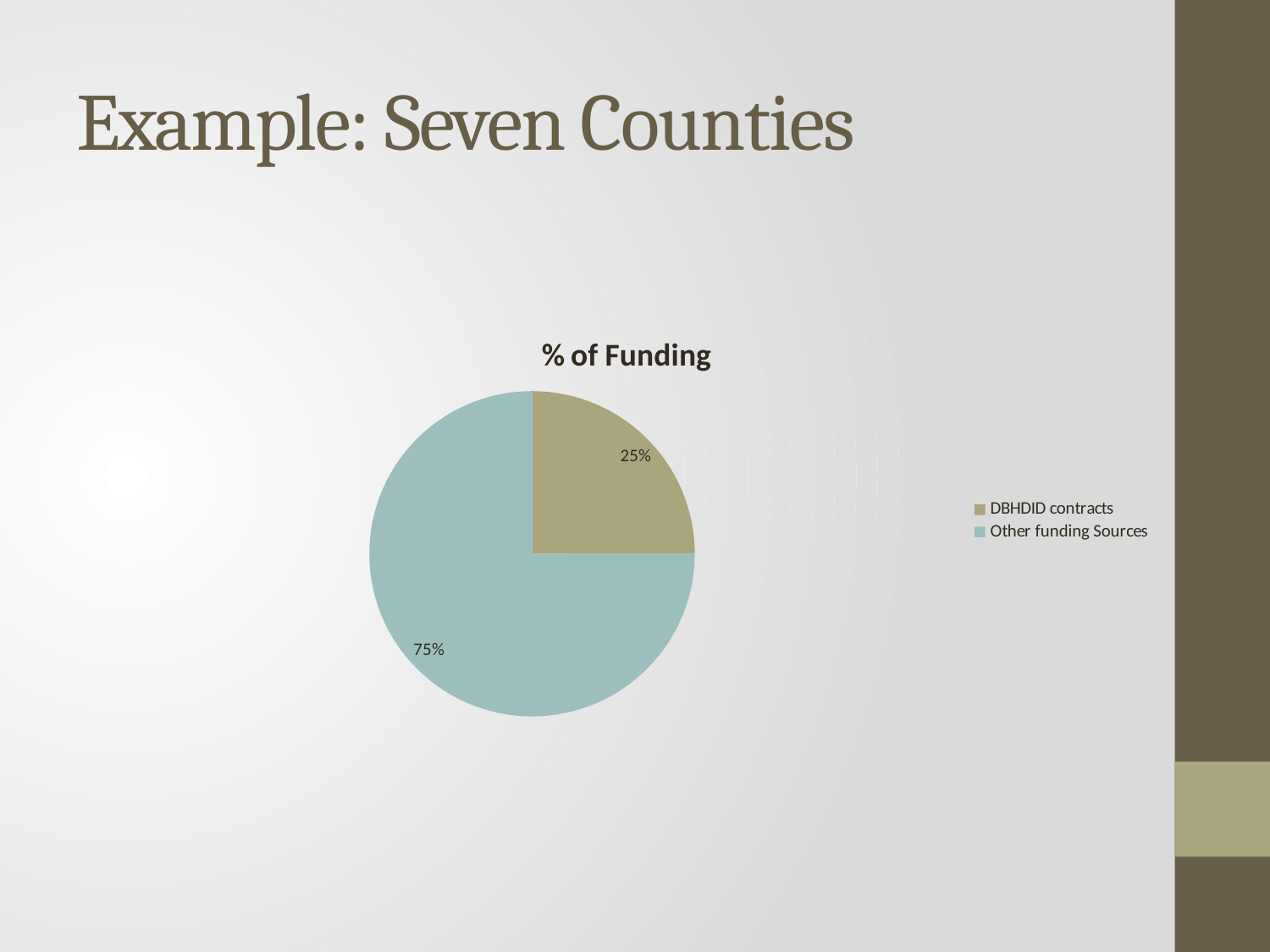
How many entries does the legend list? 2 What colour is the slice for Other funding Sources? light blue What is the difference in percentage points between Other funding Sources and DBHDID contracts? 50 What type of chart is shown on the slide? pie chart Which is larger: the share for DBHDID contracts or the share for Other funding Sources? Other funding Sources What is the title of the chart? % of Funding How many slices does the pie chart have? 2 Which funding source has the smallest share of the pie? DBHDID contracts Which funding source has the largest share of the pie? Other funding Sources What share of funding comes from DBHDID contracts? 25% What share of funding comes from Other funding Sources? 75%